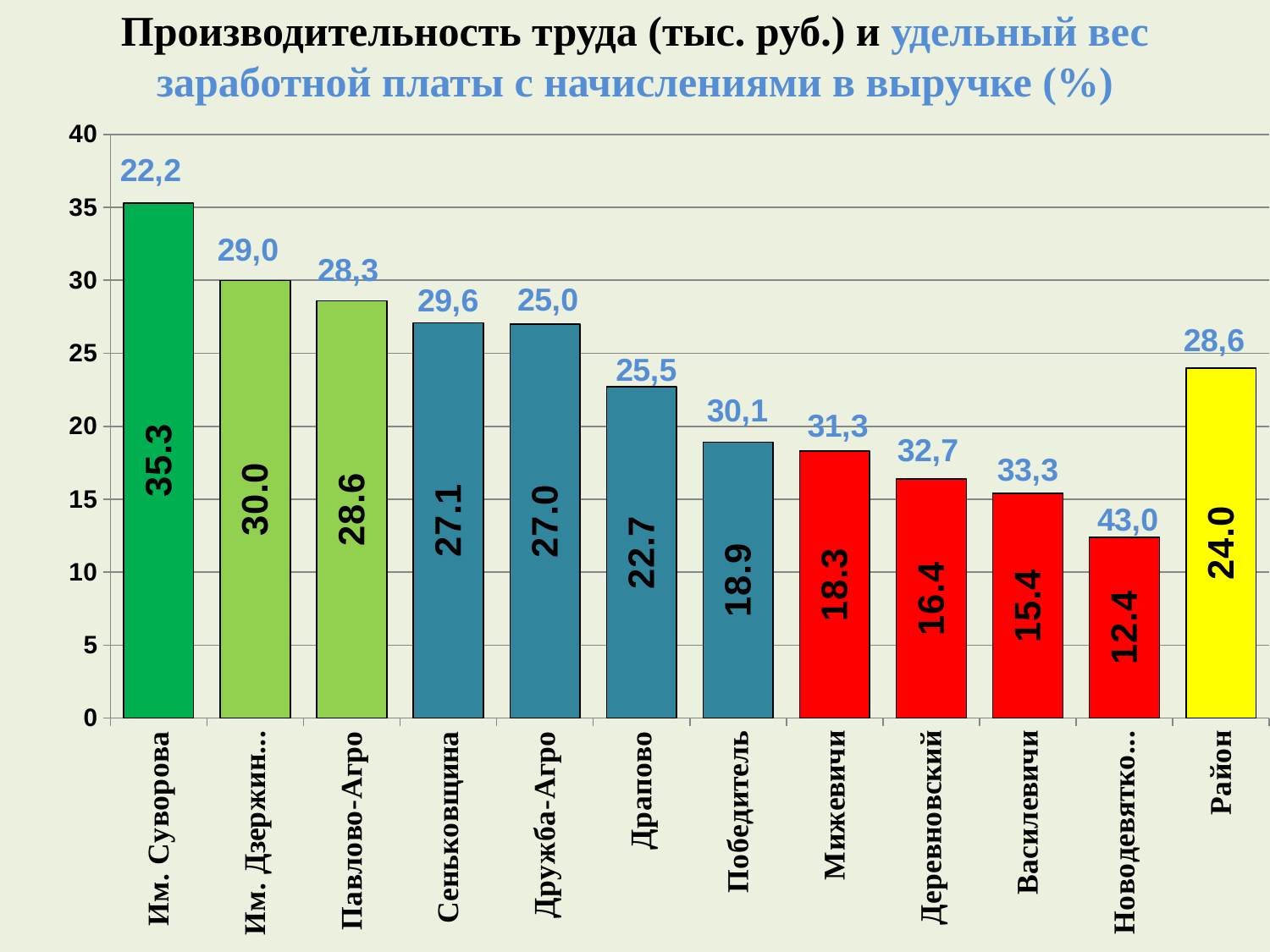
What is the difference in labor productivity between Павлово-Агро and Мижевичи? 10.3 Which has the larger labor productivity bar, Победитель or Деревновский? Победитель Is the labor productivity bar for Район greater or less than 20? greater What is the labor productivity value shown inside the bar for Район? 24.0 What is the share of wages in revenue (%) shown above the bar for Василевичи? 33,3 How many bars (categories) are plotted on the chart? 12 What kind of chart is shown on the slide? bar chart What is the labor productivity value shown inside the bar for Драпово? 22.7 Which category has the lowest share of wages in revenue (blue label above the bar)? Им. Суворова Which category has the highest labor productivity bar? Им. Суворова What is the share of wages in revenue (%) shown above the bar for Сеньковщина? 29,6 What is the labor productivity value (тыс. руб.) shown inside the bar for Им. Суворова? 35.3